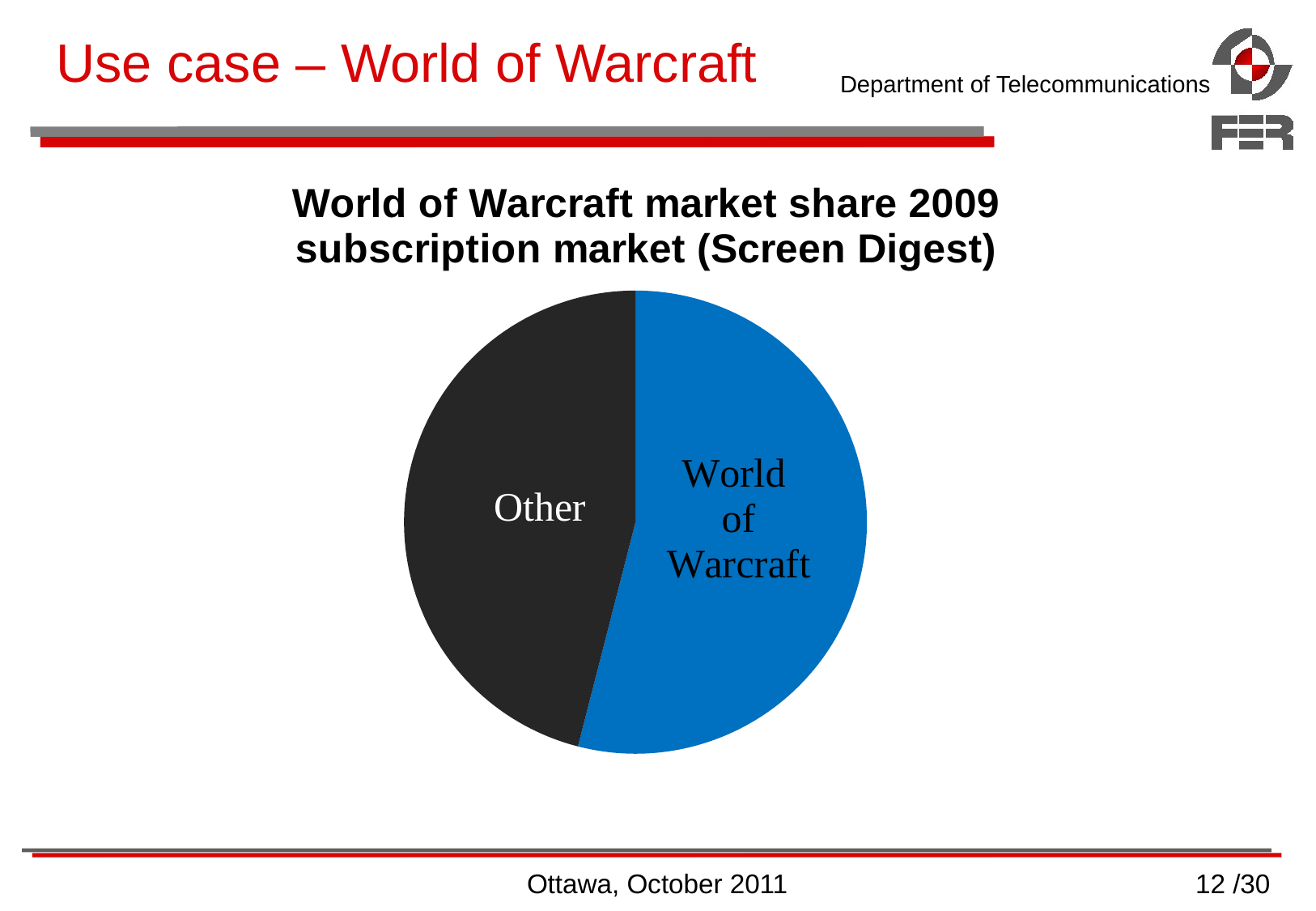
Which slice of the pie chart is the largest? World of Warcraft What is the title of the pie chart? World of Warcraft market share 2009 subscription market (Screen Digest) What kind of chart is shown on the slide? pie chart Which colour is used for the World of Warcraft slice? blue Which slice of the pie chart is the smallest? Other How many slices does the pie chart have? 2 Which slice is larger, World of Warcraft or Other? World of Warcraft